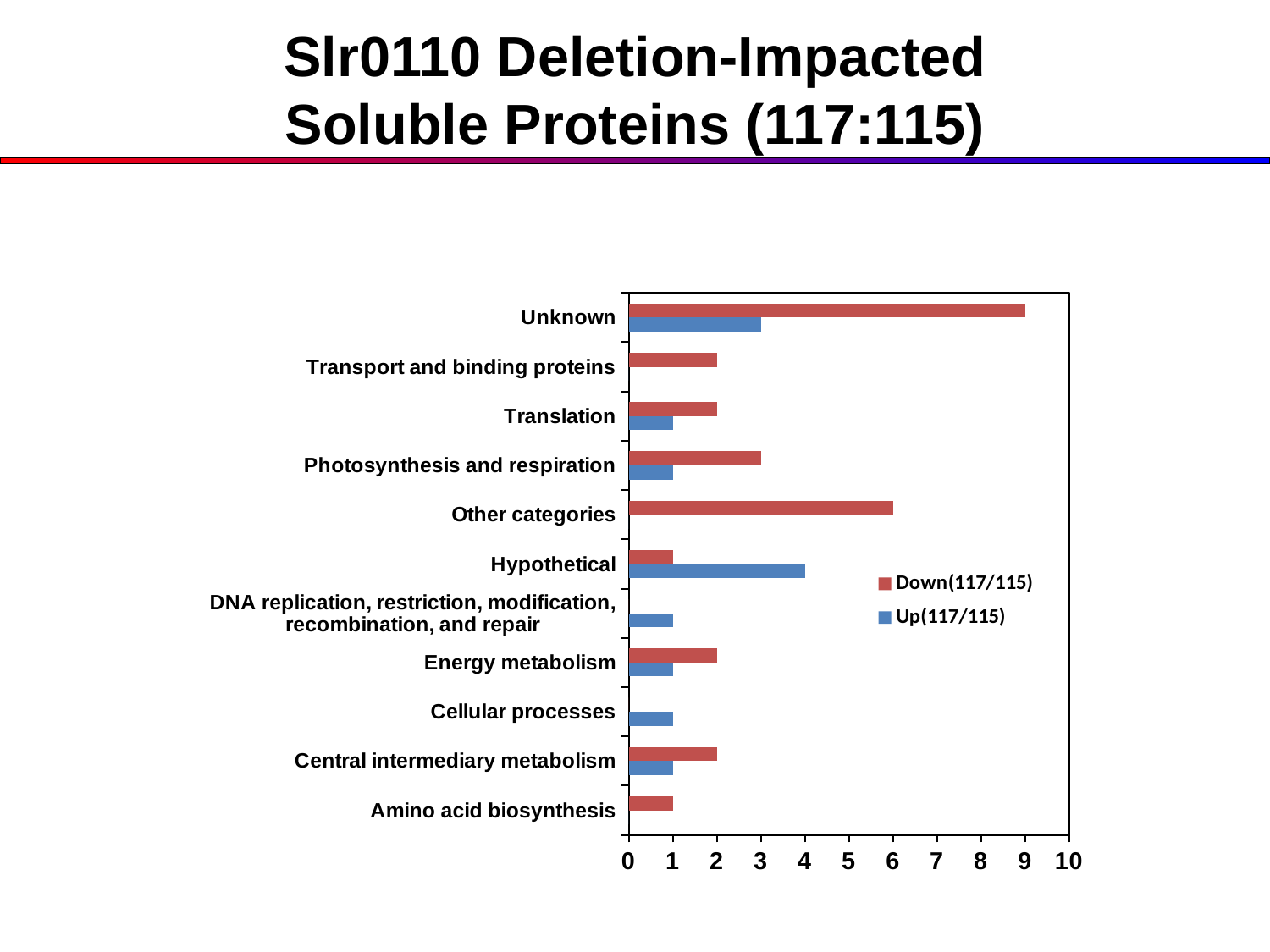
For Hypothetical, which is larger: the Down(117/115) value or the Up(117/115) value? Up(117/115) How many categories are shown on the chart? 11 What is the Down(117/115) value for Other categories? 6 Which category has the highest Down(117/115) value? Unknown What is the Down(117/115) value for Unknown? 9 What is the Up(117/115) value for Hypothetical? 4 What kind of chart is shown on the slide? Bar chart What colour are the Down(117/115) bars? Red What is the difference between the Down(117/115) and Up(117/115) values for Unknown? 6 How many series does the legend list? 2 Is the Down(117/115) value for Unknown greater or less than 5? greater Which category has the highest Up(117/115) value? Hypothetical